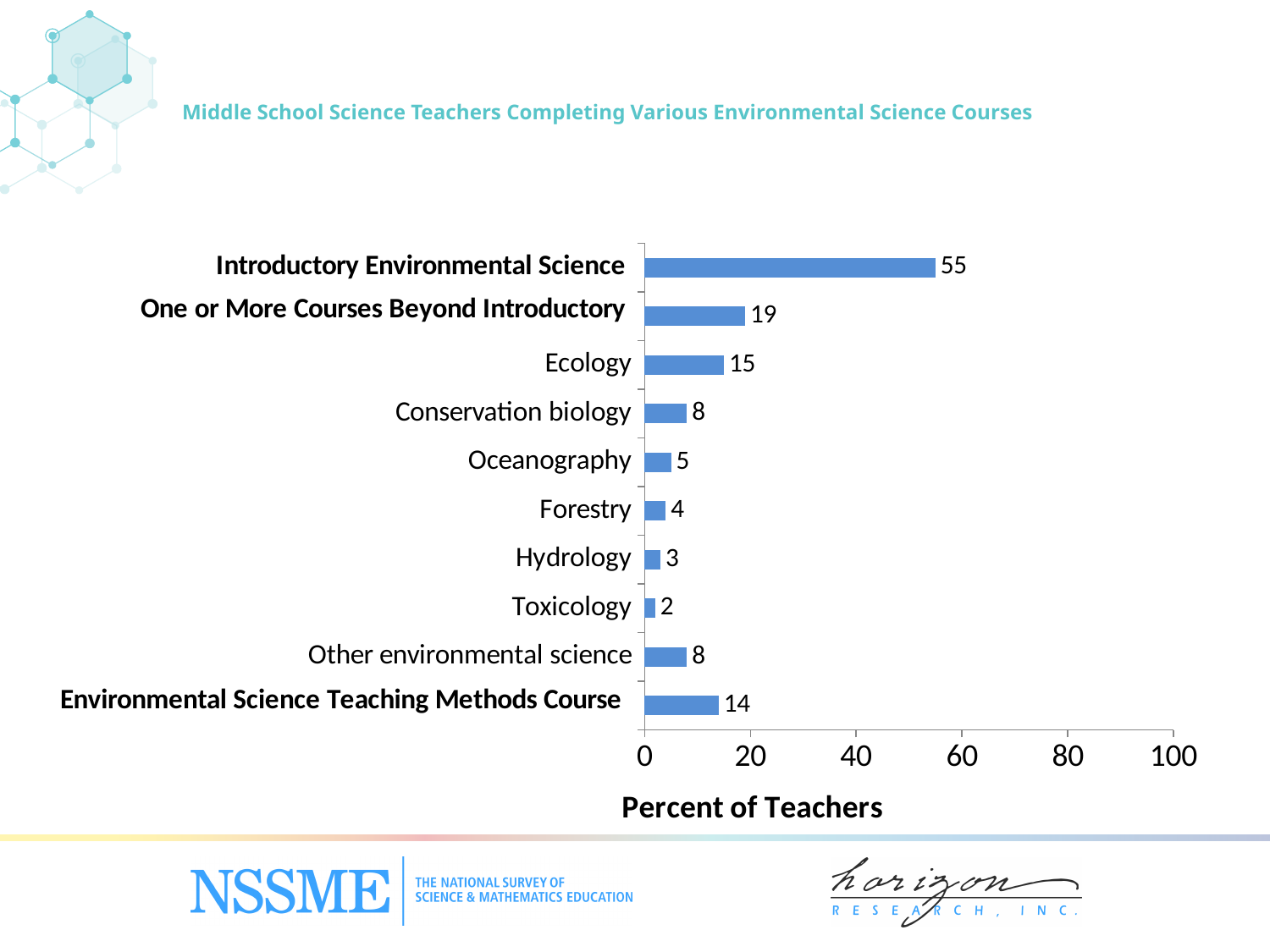
What is the difference between the values for Introductory Environmental Science and One or More Courses Beyond Introductory? 36 What is the value for Environmental Science Teaching Methods Course? 14 What is the value for Oceanography? 5 Which category has the lowest value? Toxicology Which category has the highest value? Introductory Environmental Science What kind of chart is shown on the slide? Bar chart Is the value for Introductory Environmental Science greater or less than 40? greater What is the label of the horizontal axis? Percent of Teachers How many categories are shown in the chart? 10 Which is larger, the value for Ecology or the value for Environmental Science Teaching Methods Course? Ecology What is the value for Ecology? 15 What percent of teachers completed Introductory Environmental Science? 55